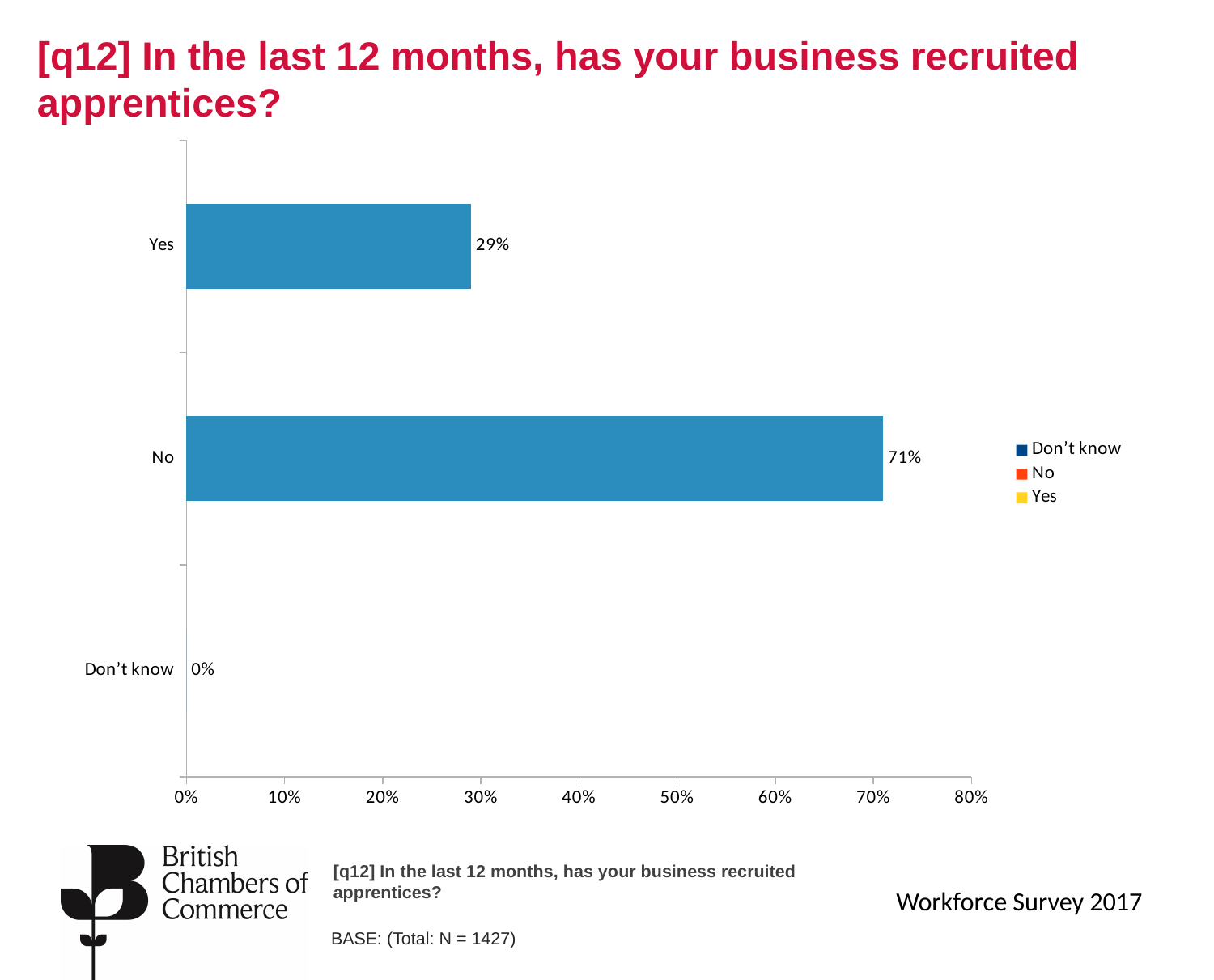
Which category has the highest value? No What is the value shown for "Don't know"? 0% Is the value for "No" greater or less than 60%? greater What is the highest value shown on the horizontal axis? 80% What is the value shown for the "No" category? 71% What kind of chart is shown on the slide? Bar chart Which category has the lowest value? Don't know What percentage of businesses answered "Yes" to having recruited apprentices in the last 12 months? 29% Which is larger, the value for "Yes" or the value for "No"? No What is the difference between the "No" and "Yes" values? 42% How many entries does the legend list? 3 How many categories are shown on the chart? 3